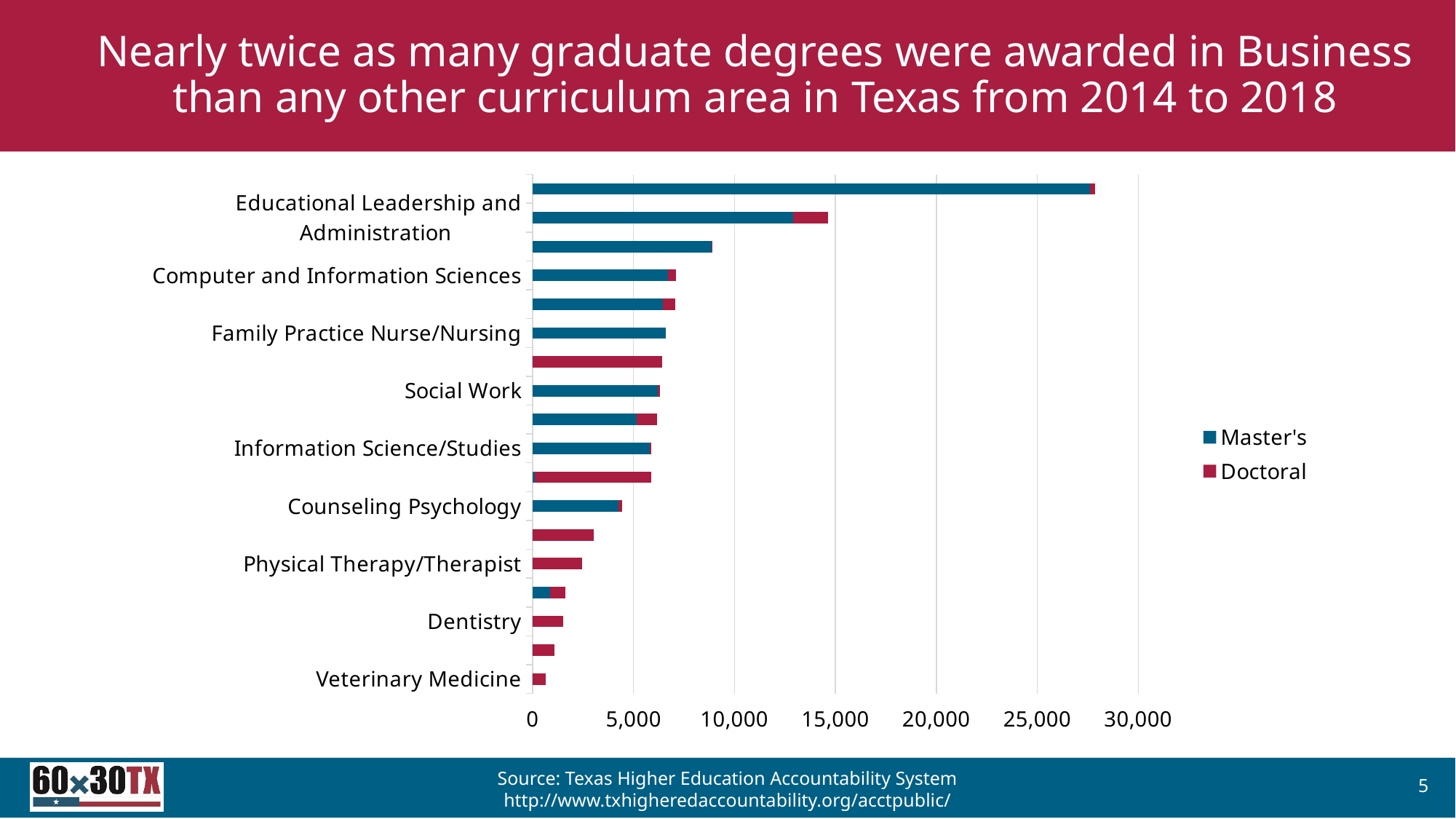
Is the total value for Computer and Information Sciences greater or less than 5,000? greater Is the value for Veterinary Medicine greater or less than 5,000? less How many bars are plotted in the chart? 18 What are the two series named in the legend? Master's and Doctoral Is the total value for Educational Leadership and Administration greater or less than 10,000? greater Which labeled category has the shortest bar? Veterinary Medicine How many series does the legend list? 2 Which has the larger value, Physical Therapy/Therapist or Dentistry? Physical Therapy/Therapist Which has the larger total, Educational Leadership and Administration or Computer and Information Sciences? Educational Leadership and Administration What kind of chart is shown on the slide? Bar chart